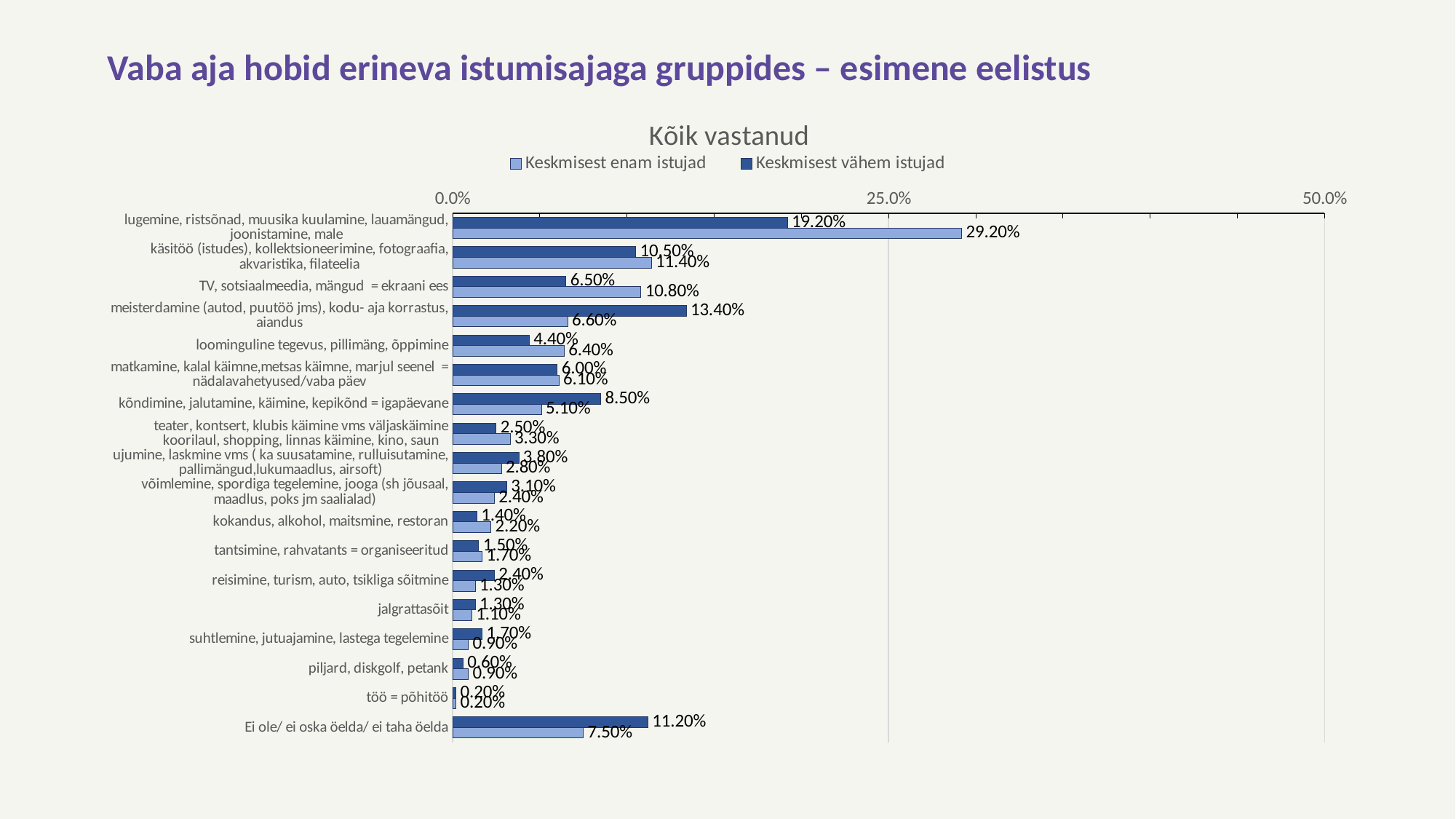
What is the title of the chart? Kõik vastanud What is the difference between the "Keskmisest enam istujad" and "Keskmisest vähem istujad" values for "lugemine, ristsõnad, muusika kuulamine, lauamängud, joonistamine, male"? 10.00% How many categories are shown on the chart? 18 Is the value for "Keskmisest enam istujad" in "lugemine, ristsõnad, muusika kuulamine, lauamängud, joonistamine, male" greater or less than 25.0%? greater Which category has the lowest value for "Keskmisest vähem istujad"? töö = põhitöö What kind of chart is shown on the slide? bar chart What is the value for "Keskmisest vähem istujad" in the category "kõndimine, jalutamine, käimine, kepikõnd = igapäevane"? 8.50% Which category has the highest value for "Keskmisest enam istujad"? lugemine, ristsõnad, muusika kuulamine, lauamängud, joonistamine, male How many series does the legend list? 2 What is the value for "Keskmisest enam istujad" in the category "TV, sotsiaalmeedia, mängud = ekraani ees"? 10.80% For "meisterdamine (autod, puutöö jms), kodu- aja korrastus, aiandus", which series has the larger value: "Keskmisest enam istujad" or "Keskmisest vähem istujad"? Keskmisest vähem istujad What is the value for "Keskmisest vähem istujad" in the category "Ei ole/ ei oska öelda/ ei taha öelda"? 11.20%